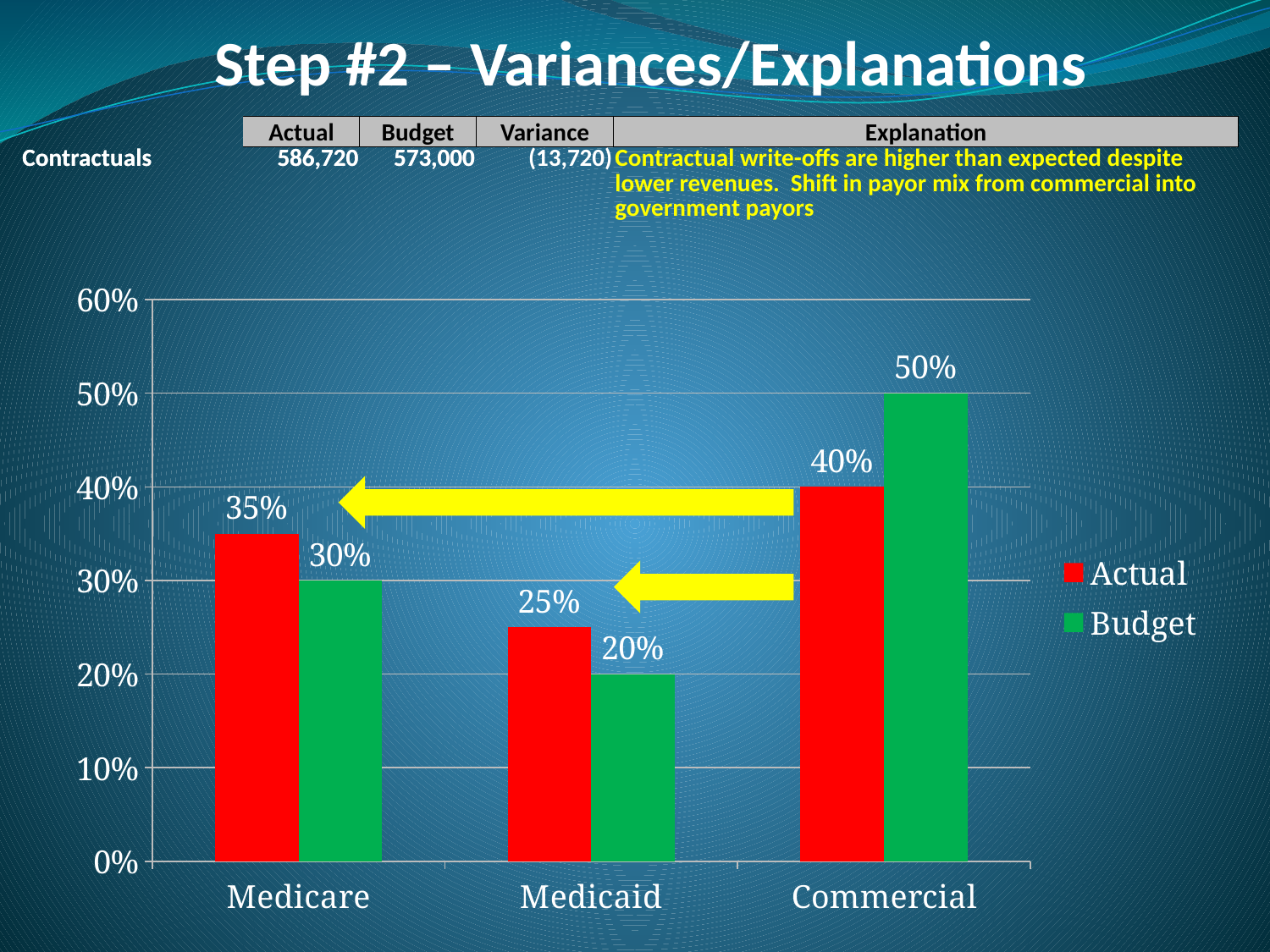
Which category has the lowest Actual value? Medicaid What is the Actual value for Medicare? 35% Which category has the highest Budget value? Commercial Which is larger for Medicare, the Actual value or the Budget value? Actual How many series does the chart legend list? 2 How many categories are shown on the x axis of the chart? 3 What is the Actual value for Commercial? 40% What kind of chart is shown on the slide? Bar chart What is the Budget value for Medicaid? 20% What is the Budget value for Commercial? 50% What is the difference between the Budget and Actual values for Commercial? 10% What colour are the Budget bars in the chart? Green